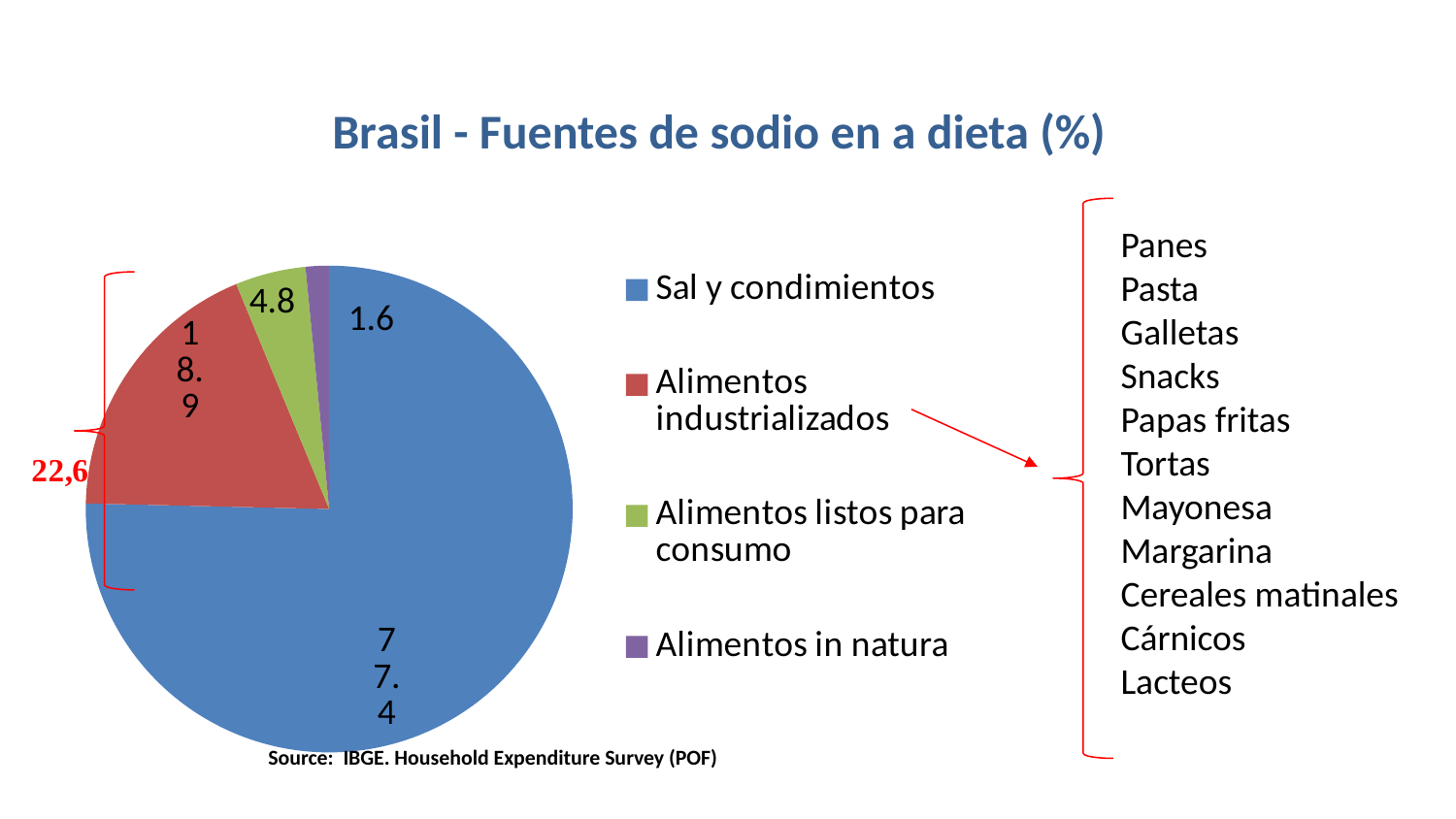
What is the value for Alimentos listos para consumo? 4.8 How many categories does the pie chart have? 4 What type of chart is shown on the slide? pie chart What is the value for Alimentos in natura? 1.6 Which colour represents Alimentos industrializados in the pie chart? red Which category has the smallest slice of the pie? Alimentos in natura What is the title of the chart? Brasil - Fuentes de sodio en a dieta (%) What is the value for Alimentos industrializados? 18.9 Which category has the largest slice of the pie? Sal y condimientos Which is larger, the value for Alimentos listos para consumo or the value for Alimentos in natura? Alimentos listos para consumo What is the value for Sal y condimientos? 77.4 What is the difference between the values for Alimentos industrializados and Alimentos listos para consumo? 14.1